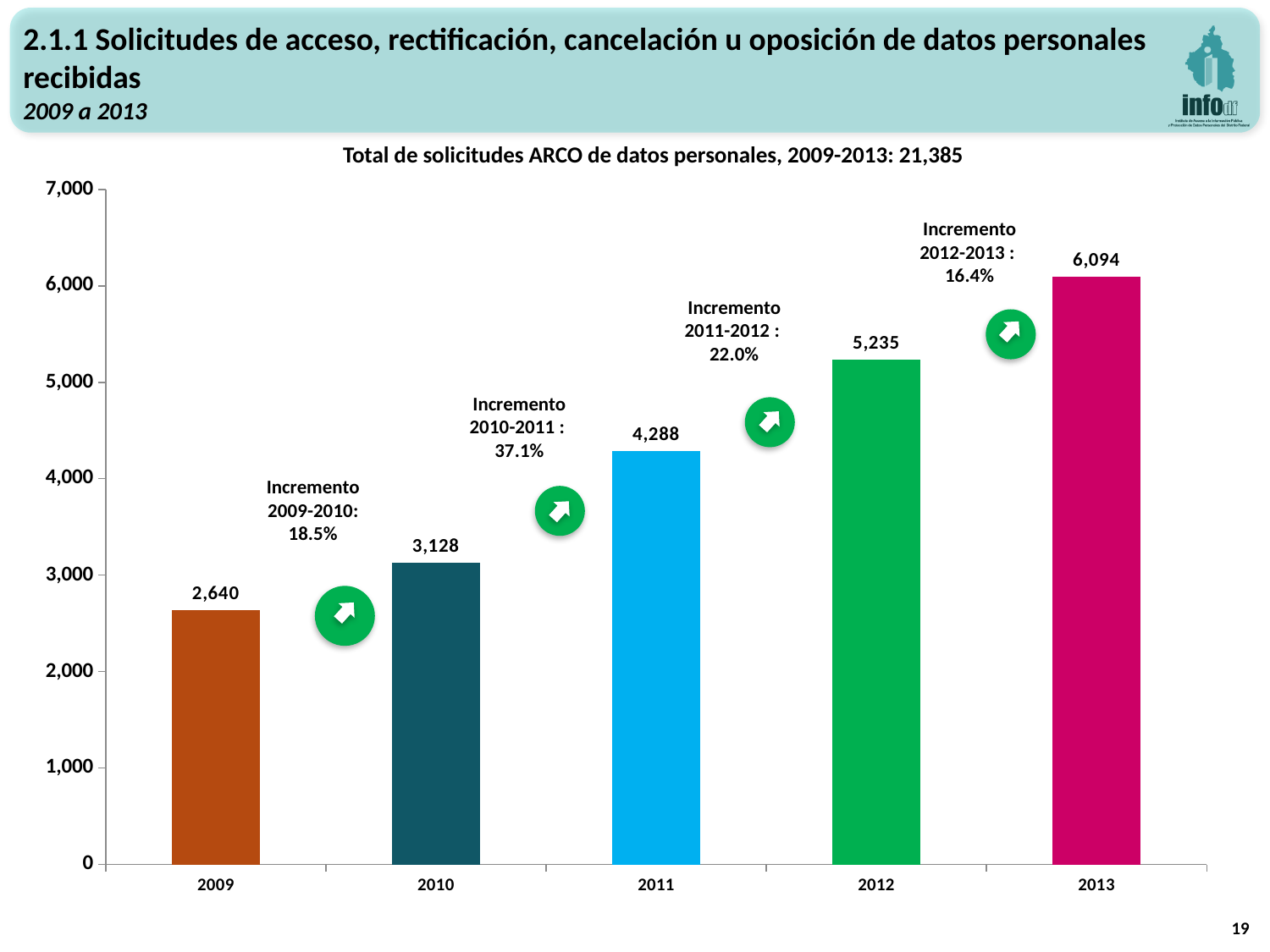
Is the value for 2012 greater or less than 5,000? greater What is the value for 2009? 2,640 What is the difference between the values for 2013 and 2012? 859 Which is larger, the value for 2011 or the value for 2010? 2011 What kind of chart is shown on the slide? bar chart What is the value for 2013? 6,094 Which year has the lowest value? 2009 Do the values rise or fall from 2009 to 2013? rise What is the value for 2011? 4,288 How many years are shown on the x axis? 5 Which year has the highest value? 2013 What is the difference between the values for 2010 and 2009? 488